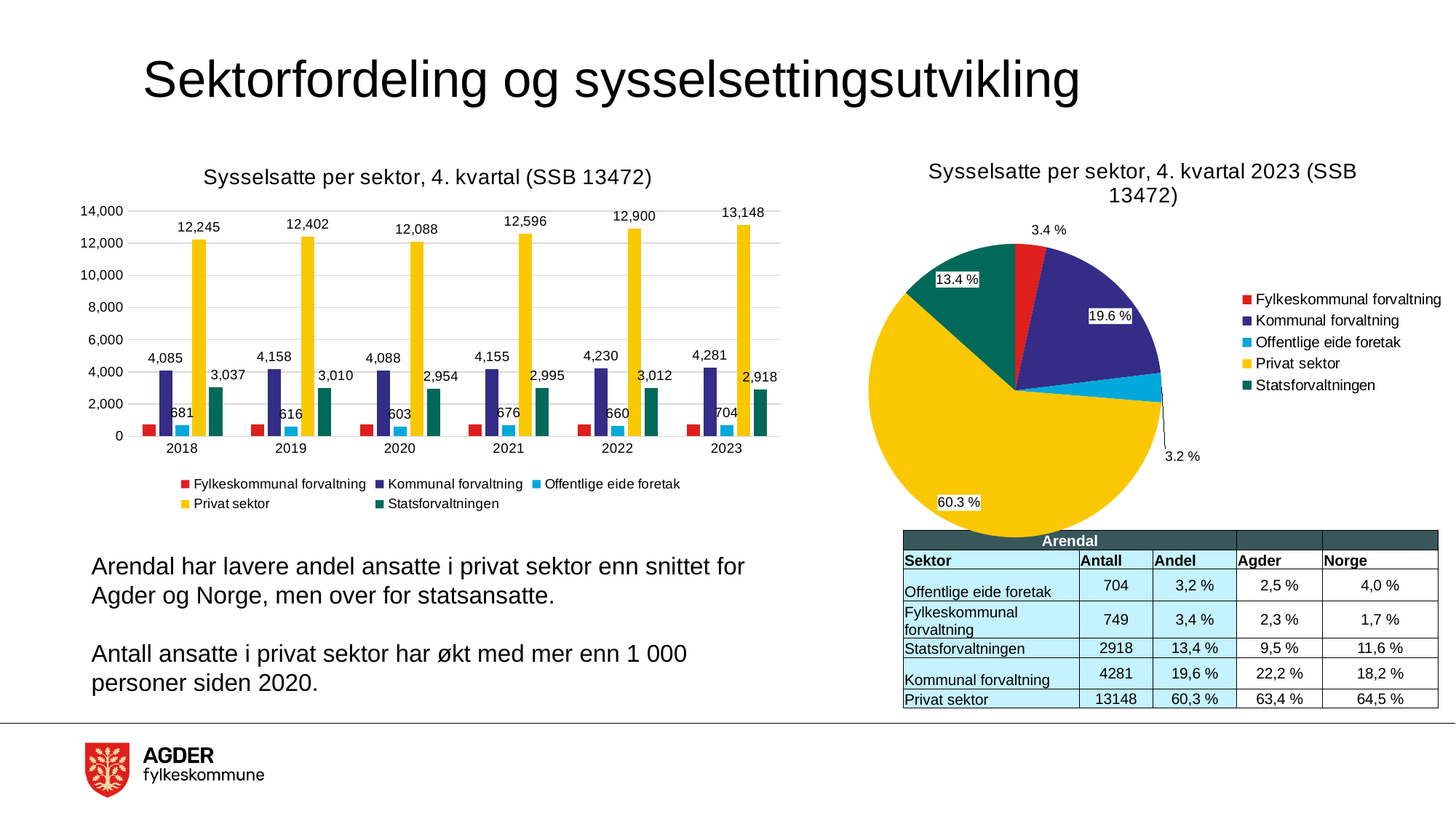
What kind of chart is the chart on the right of the slide, 'Sysselsatte per sektor, 4. kvartal 2023 (SSB 13472)'? Pie chart In the bar chart 'Sysselsatte per sektor, 4. kvartal (SSB 13472)', in which year is the Statsforvaltningen value highest? 2018 In the pie chart 'Sysselsatte per sektor, 4. kvartal 2023 (SSB 13472)', what share does Privat sektor have? 60.3 % In the bar chart 'Sysselsatte per sektor, 4. kvartal (SSB 13472)', what is the value for Kommunal forvaltning in 2019? 4,158 How many series does the legend of the bar chart 'Sysselsatte per sektor, 4. kvartal (SSB 13472)' list? 5 How many years are shown on the x axis of the bar chart 'Sysselsatte per sektor, 4. kvartal (SSB 13472)'? 6 In the bar chart 'Sysselsatte per sektor, 4. kvartal (SSB 13472)', is the Statsforvaltningen value in 2022 or in 2023 larger? 2022 In the bar chart 'Sysselsatte per sektor, 4. kvartal (SSB 13472)', what is the difference between the Privat sektor values in 2023 and 2020? 1,060 In the bar chart 'Sysselsatte per sektor, 4. kvartal (SSB 13472)', what is the value for Offentlige eide foretak in 2020? 603 In the bar chart 'Sysselsatte per sektor, 4. kvartal (SSB 13472)', in which year is the Privat sektor value lowest? 2020 In the bar chart 'Sysselsatte per sektor, 4. kvartal (SSB 13472)', what is the value for Privat sektor in 2023? 13,148 In the bar chart 'Sysselsatte per sektor, 4. kvartal (SSB 13472)', is the value for Fylkeskommunal forvaltning in 2021 greater or less than 2,000? less